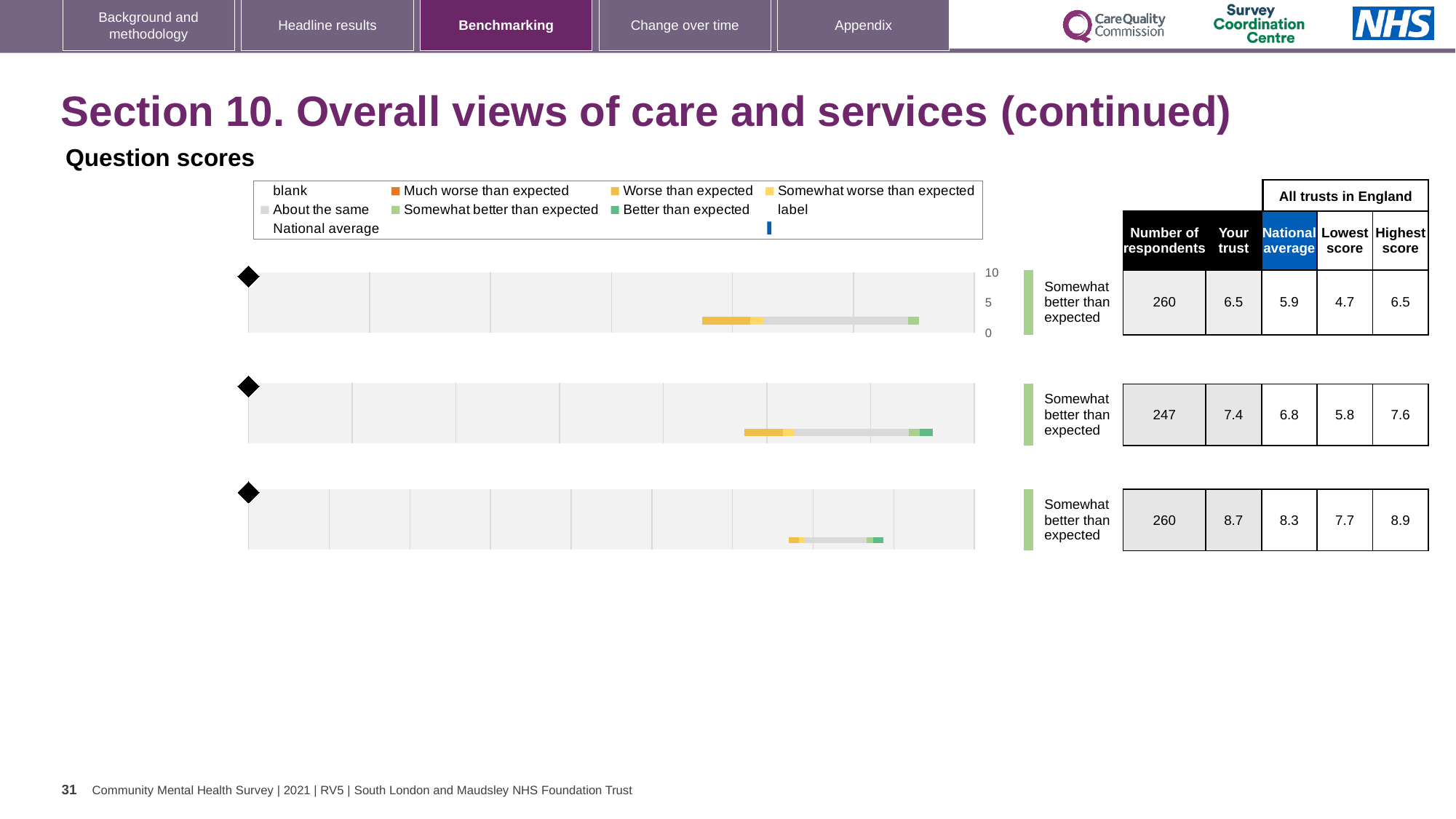
For the top chart, what is the National average score? 5.9 Which of the three charts has the highest Your trust score? The bottom chart (8.7) For the bottom chart, what is the Highest score among all trusts in England? 8.9 For the bottom chart, is Your trust score greater or less than the National average? Greater For the middle chart, what is the difference between Your trust score and the National average? 0.6 For the top chart, what is the score for Your trust? 6.5 For the middle chart, how many respondents are there? 247 What benchmark category is shown for the middle chart? Somewhat better than expected In the legend, which colour represents 'Much worse than expected'? Orange For the top chart, what is the difference between the Highest score and the Lowest score? 1.8 How many question-score charts are shown on the slide? 3 What kind of chart is used for the three question scores on this slide? Bar chart